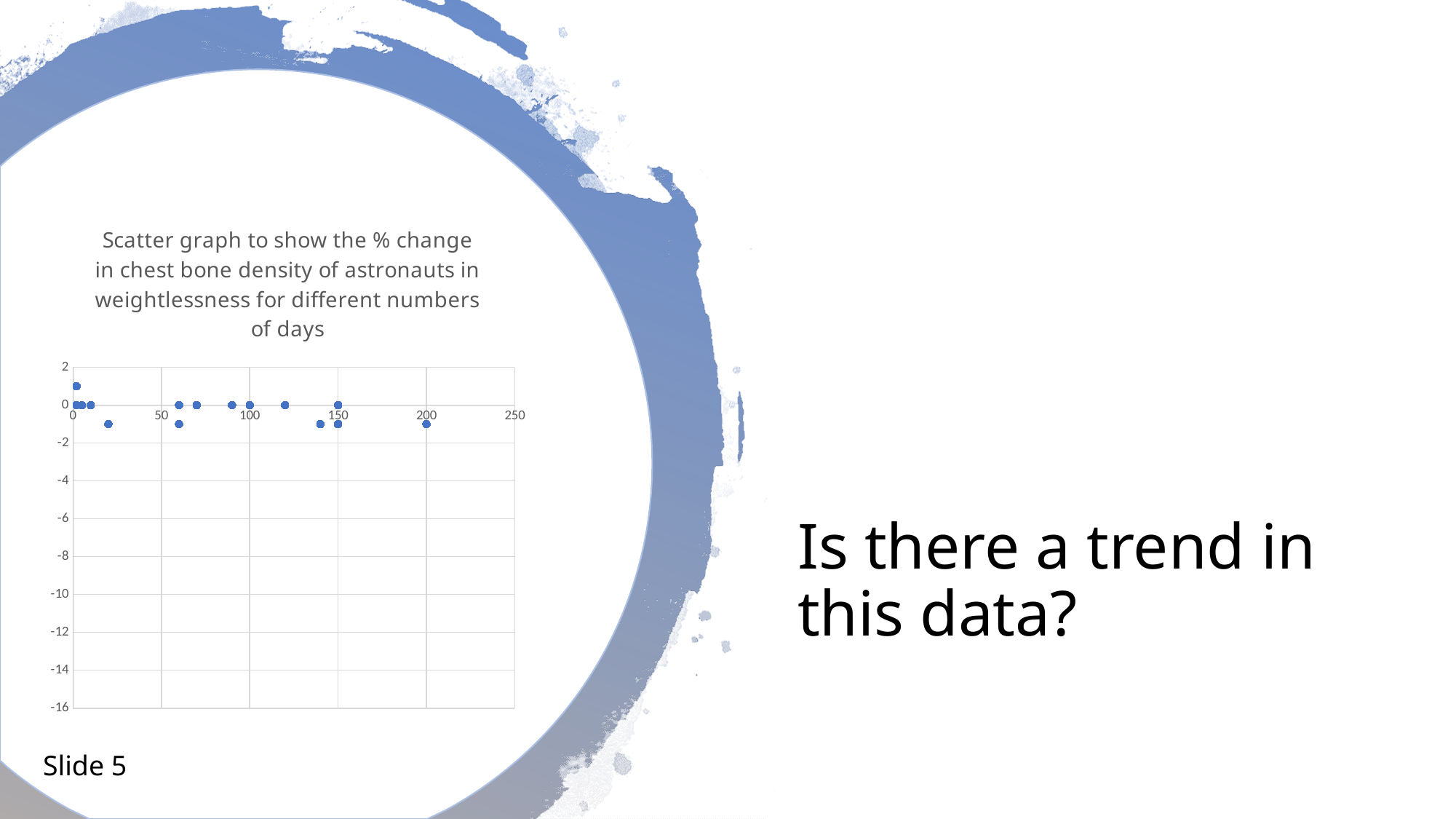
What kind of chart is shown on the slide? scatter chart Are any of the plotted points below -4 on the y axis? no Is the value plotted at 200 days greater or less than -2? greater Is the value plotted at 200 days greater or less than 0? less What is the maximum value shown on the x axis? 250 What is the title of the chart? Scatter graph to show the % change in chest bone density of astronauts in weightlessness for different numbers of days Do the plotted values show a clear rise or fall as the number of days increases? no clear trend